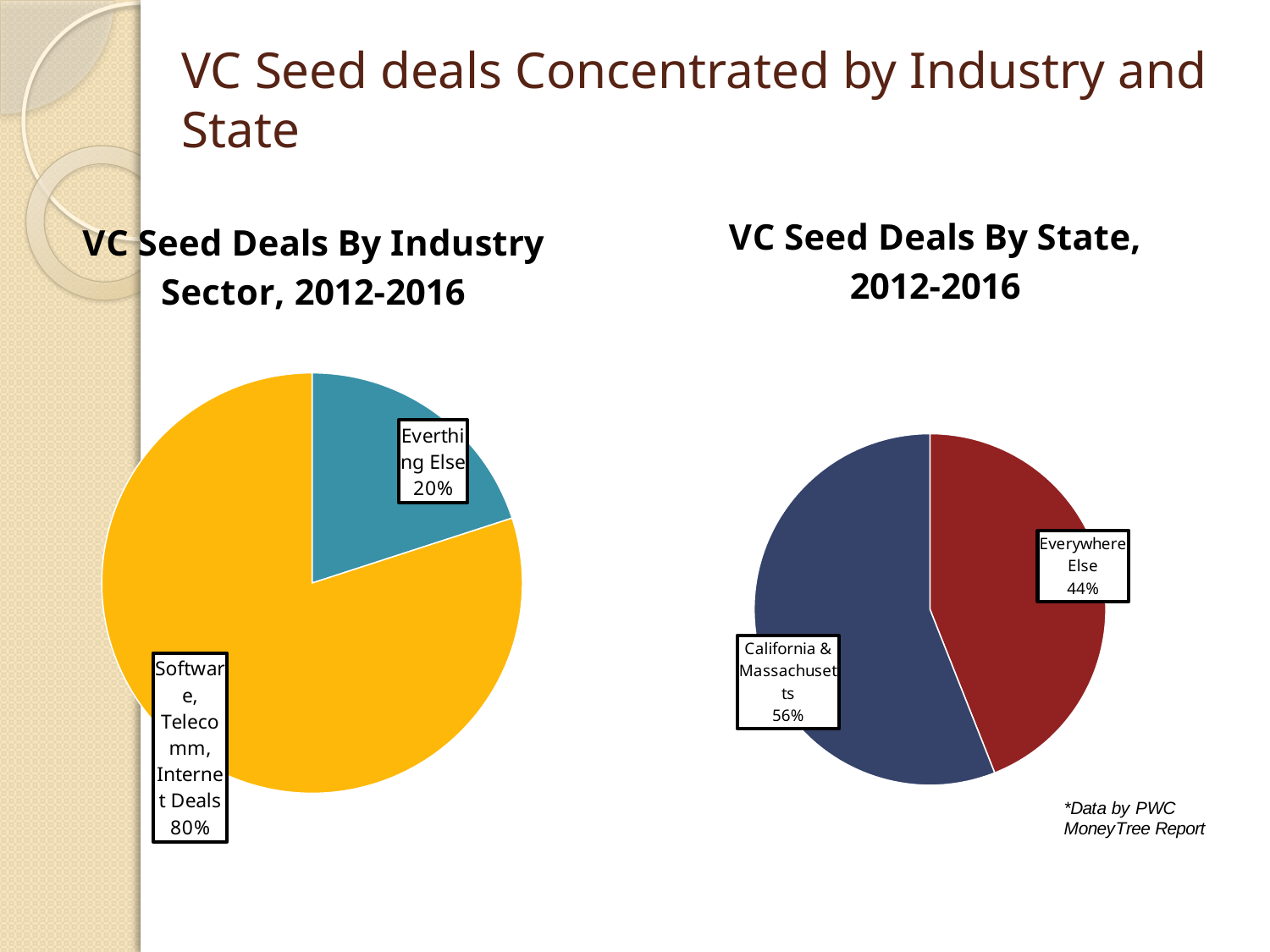
In the 'VC Seed Deals By State, 2012-2016' chart, which slice is the smallest? Everywhere Else In the 'VC Seed Deals By State, 2012-2016' chart, which is larger: California & Massachusetts or Everywhere Else? California & Massachusetts What type of chart is the 'VC Seed Deals By State, 2012-2016' chart? Pie chart In the 'VC Seed Deals By Industry Sector, 2012-2016' chart, which slice is the largest? Software, Telecomm, Internet Deals In the 'VC Seed Deals By State, 2012-2016' chart, what share of deals is California & Massachusetts? 56% In the 'VC Seed Deals By Industry Sector, 2012-2016' chart, what share of deals is Everthing Else? 20% In the 'VC Seed Deals By State, 2012-2016' chart, what is the difference in percentage points between California & Massachusetts and Everywhere Else? 12 percentage points How many slices does the 'VC Seed Deals By Industry Sector, 2012-2016' chart have? 2 In the 'VC Seed Deals By Industry Sector, 2012-2016' chart, what is the difference in percentage points between Software, Telecomm, Internet Deals and Everthing Else? 60 percentage points In the 'VC Seed Deals By State, 2012-2016' chart, what share of deals is Everywhere Else? 44% In the 'VC Seed Deals By Industry Sector, 2012-2016' chart, what share of deals is Software, Telecomm, Internet Deals? 80% What is the title of the chart on the left side of the slide? VC Seed Deals By Industry Sector, 2012-2016